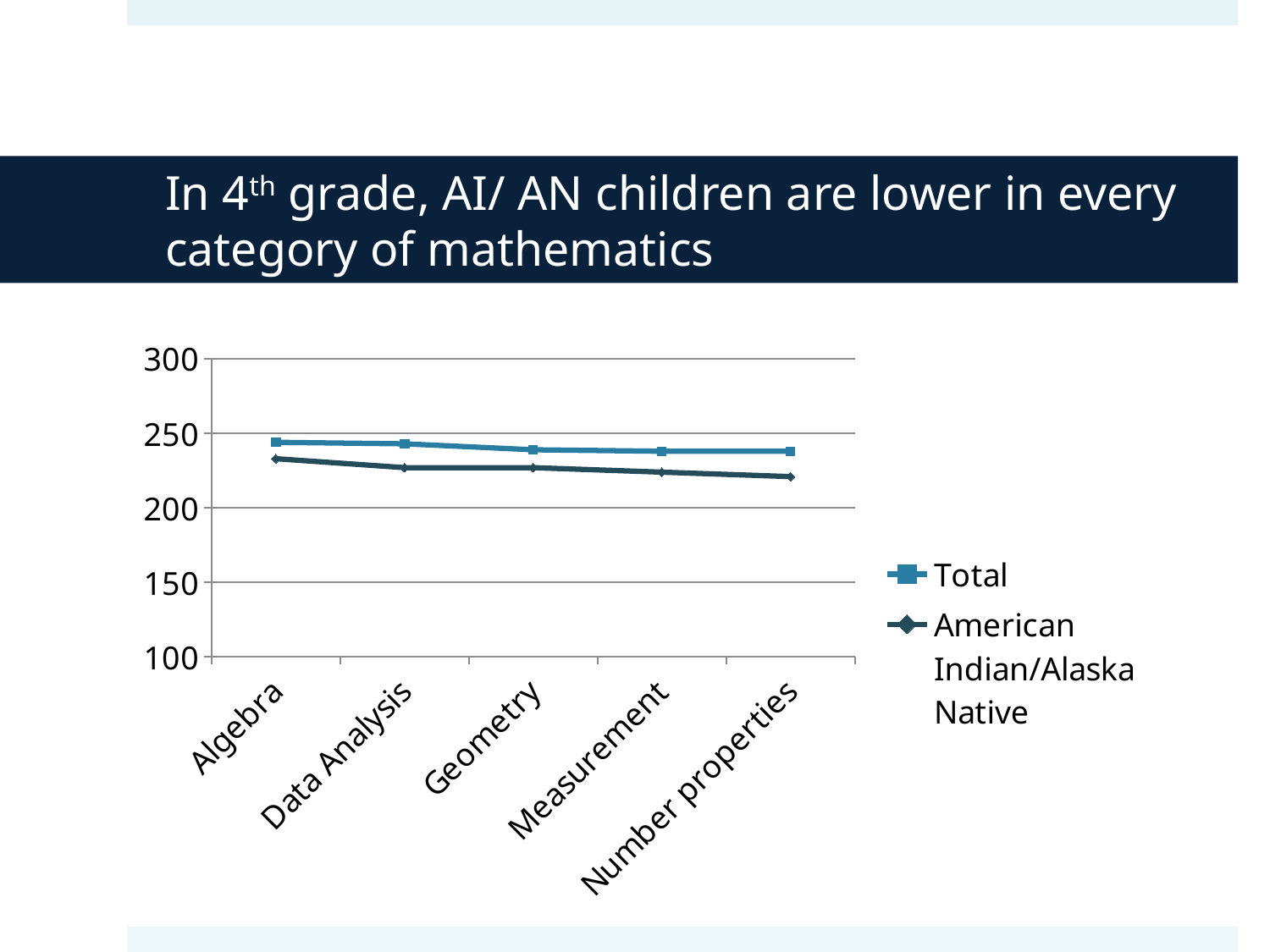
Which series has the higher value for Algebra, Total or American Indian/Alaska Native? Total Do the American Indian/Alaska Native values rise or fall from Algebra to Number properties? fall What are the two series named in the legend? Total; American Indian/Alaska Native Is the American Indian/Alaska Native value for Number properties greater or less than 250? less Is the Total value for Algebra greater or less than 200? greater How many categories are plotted along the x axis? 5 Which series has the higher value for Number properties, Total or American Indian/Alaska Native? Total Is the Total value for Geometry greater or less than 250? less How many series does the legend list? 2 What is the title of the slide containing the chart? In 4th grade, AI/ AN children are lower in every category of mathematics What kind of chart is shown on the slide? Line chart For the American Indian/Alaska Native series, which category has the highest value? Algebra